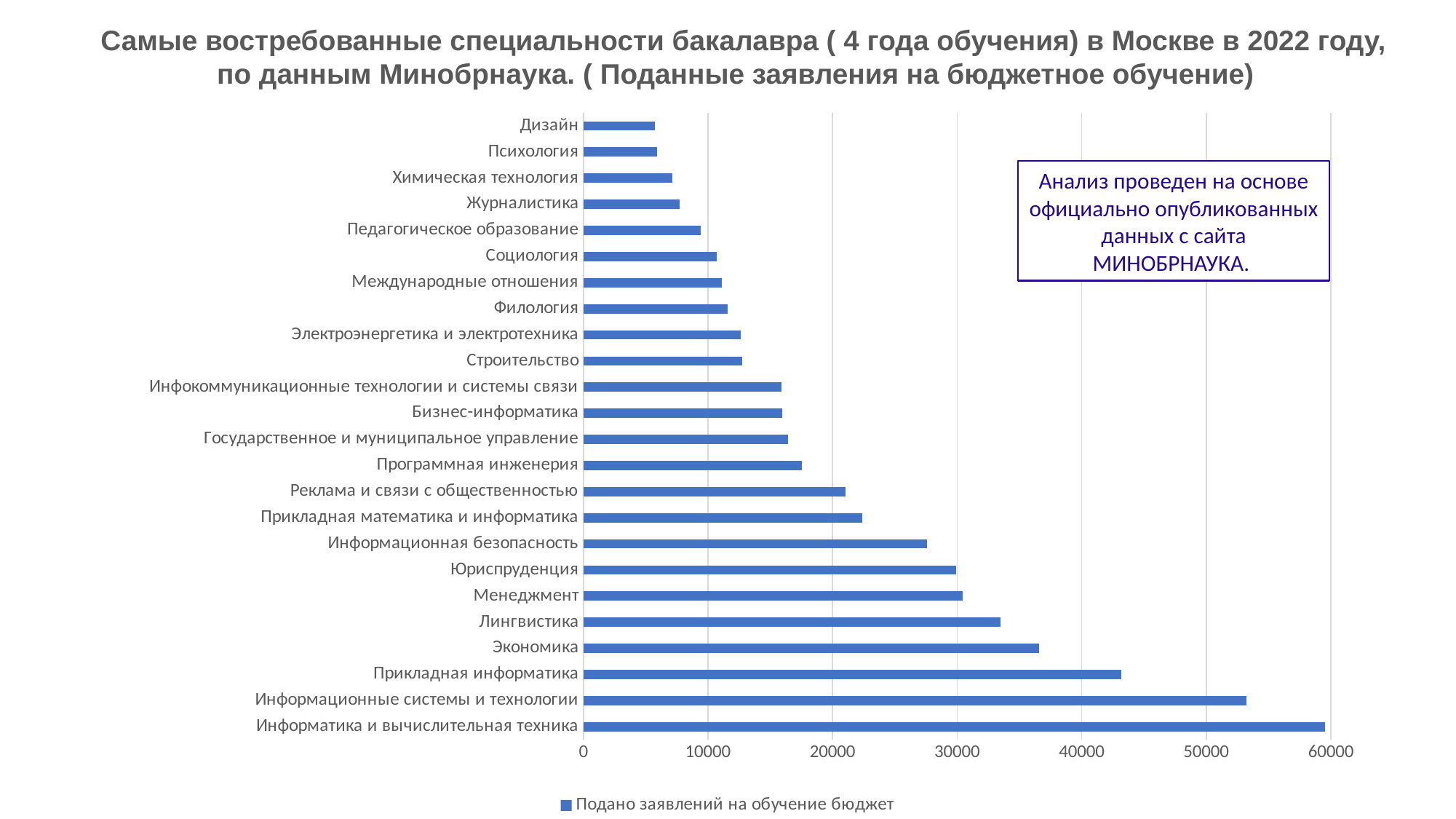
Is the value for Информационная безопасность greater or less than 30000? less How many series does the legend list? 1 Is the value for Информатика и вычислительная техника greater or less than 50000? greater What is the name of the series shown in the legend? Подано заявлений на обучение бюджет Which has more applications, Прикладная информатика or Экономика? Прикладная информатика Is the value for Экономика greater or less than 40000? less Which has more applications, Информационная безопасность or Прикладная математика и информатика? Информационная безопасность What kind of chart is shown on the slide? bar chart Which specialty has the highest number of submitted applications? Информатика и вычислительная техника How many specialties (categories) are plotted in the chart? 24